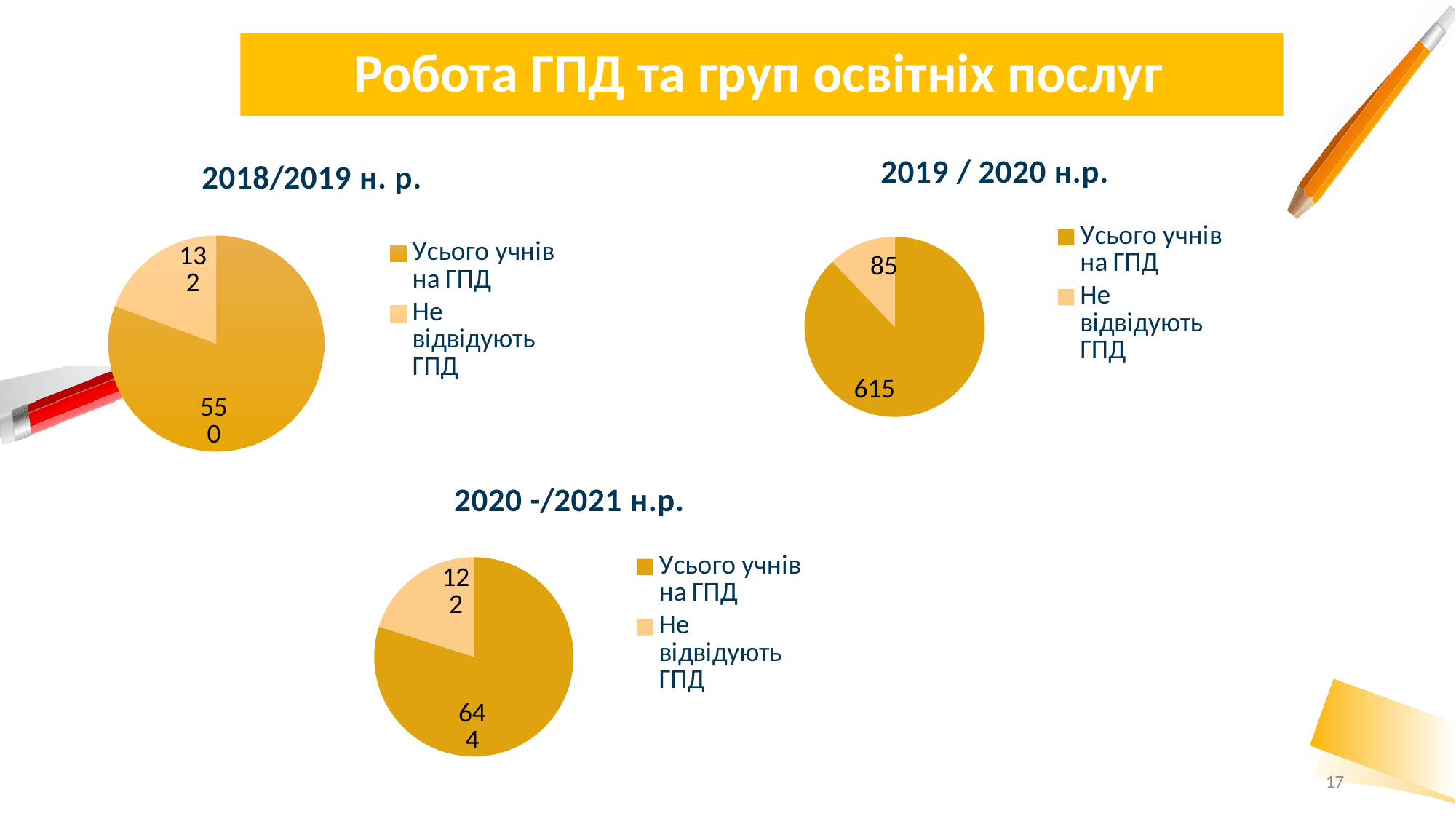
How many slices does the 2018/2019 н. р. pie chart have? 2 In the 2019 / 2020 н.р. chart, what is the total of the two slices? 700 In the 2020 -/2021 н.р. chart, what is the value for Усього учнів на ГПД? 644 In the 2018/2019 н. р. chart, what is the value for Не відвідують ГПД? 132 In the 2018/2019 н. р. chart, what is the value for Усього учнів на ГПД? 550 In the 2019 / 2020 н.р. chart, which slice is the largest? Усього учнів на ГПД In the 2020 -/2021 н.р. chart, what is the value for Не відвідують ГПД? 122 How many entries does the legend of the 2020 -/2021 н.р. chart list? 2 What kind of chart is used for the 2018/2019 н. р. data? pie chart In the 2019 / 2020 н.р. chart, what is the value for Не відвідують ГПД? 85 In the 2019 / 2020 н.р. chart, what is the value for Усього учнів на ГПД? 615 In the 2020 -/2021 н.р. chart, what is the difference between Усього учнів на ГПД and Не відвідують ГПД? 522